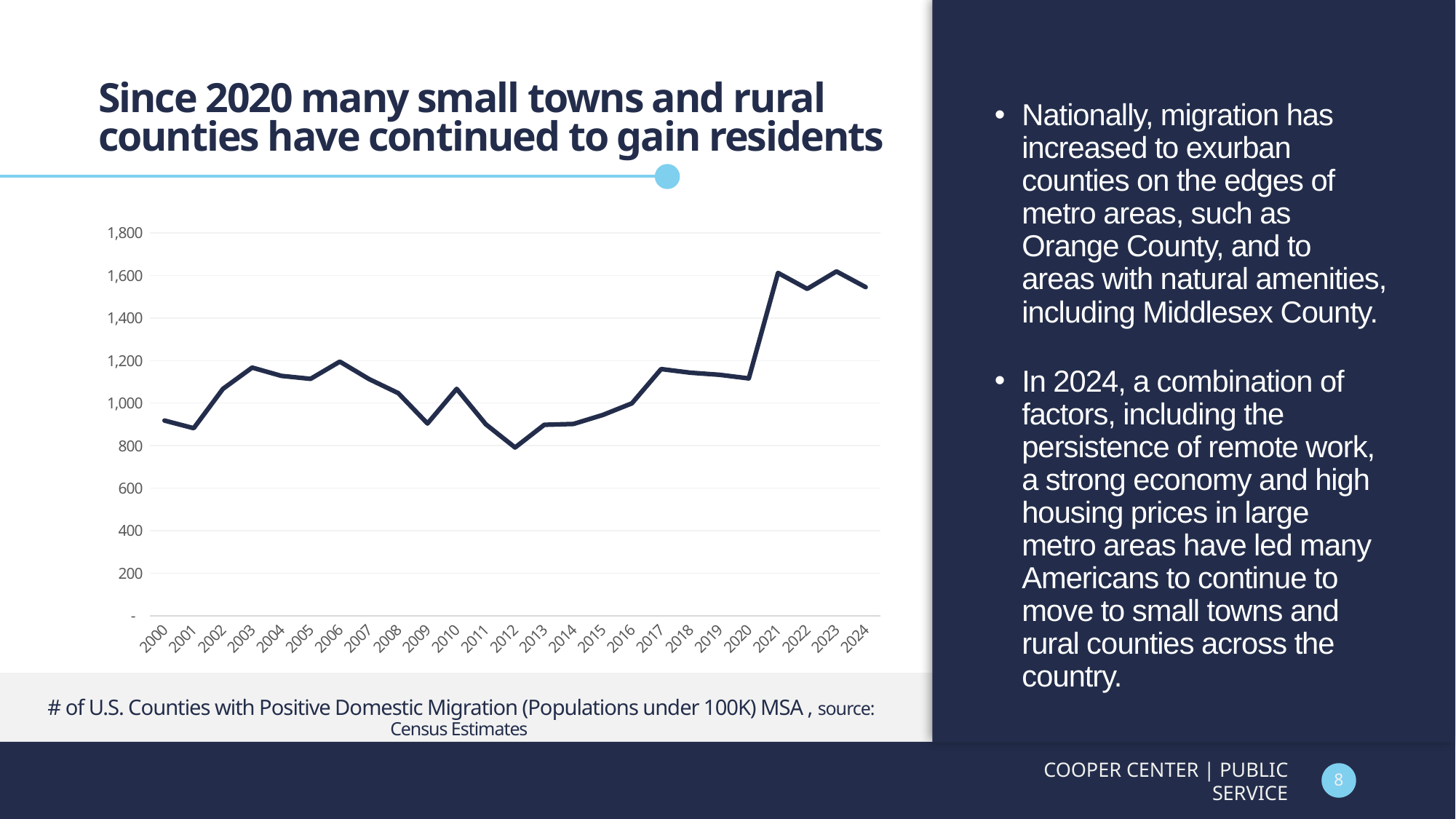
Is the value for 2021 greater or less than 1,400? greater Which year has the larger value, 2020 or 2021? 2021 What is the caption describing the chart's data? # of U.S. Counties with Positive Domestic Migration (Populations under 100K) MSA, source: Census Estimates Is the value for 2006 greater or less than 1,000? greater Is the value for 2012 greater or less than 1,000? less Which year has the lowest number of U.S. counties with positive domestic migration? 2012 What kind of chart is shown on the slide? line chart Does the line rise or fall between 2020 and 2021? rise How many years are plotted along the x axis of the chart? 25 Which year has the larger value, 2006 or 2012? 2006